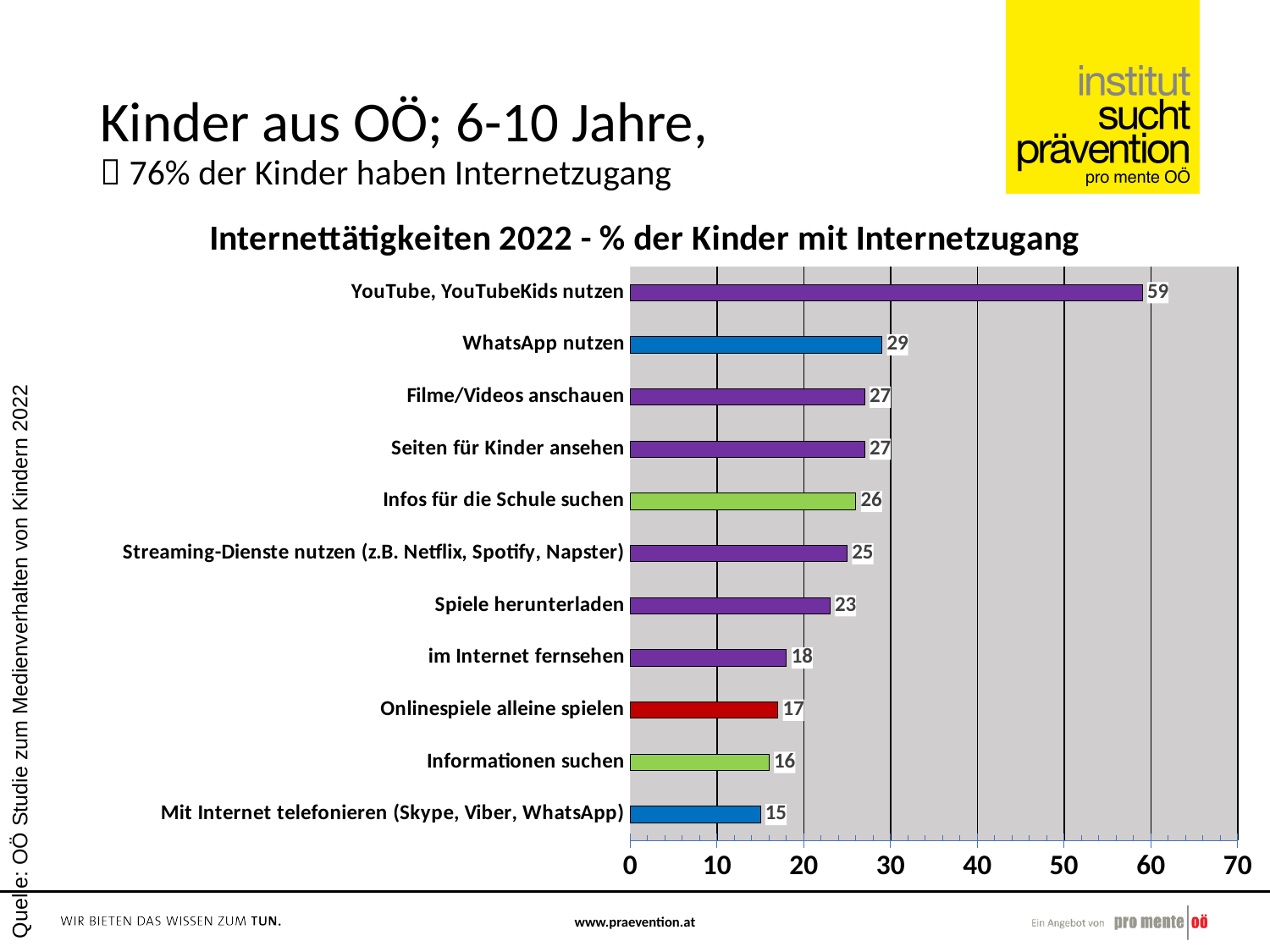
What is the value for "Infos für die Schule suchen"? 26 Which category has the highest value? YouTube, YouTubeKids nutzen What kind of chart is shown on the slide? bar chart Is the value for "Streaming-Dienste nutzen (z.B. Netflix, Spotify, Napster)" greater or less than 30? less Which is larger, the value for "Spiele herunterladen" or the value for "im Internet fernsehen"? Spiele herunterladen What is the difference between the values for "YouTube, YouTubeKids nutzen" and "WhatsApp nutzen"? 30 How many categories are shown in the chart? 11 What is the value for "YouTube, YouTubeKids nutzen"? 59 What is the value for "WhatsApp nutzen"? 29 What is the value for "Onlinespiele alleine spielen"? 17 What is the title of the chart? Internettätigkeiten 2022 - % der Kinder mit Internetzugang Which category has the lowest value? Mit Internet telefonieren (Skype, Viber, WhatsApp)